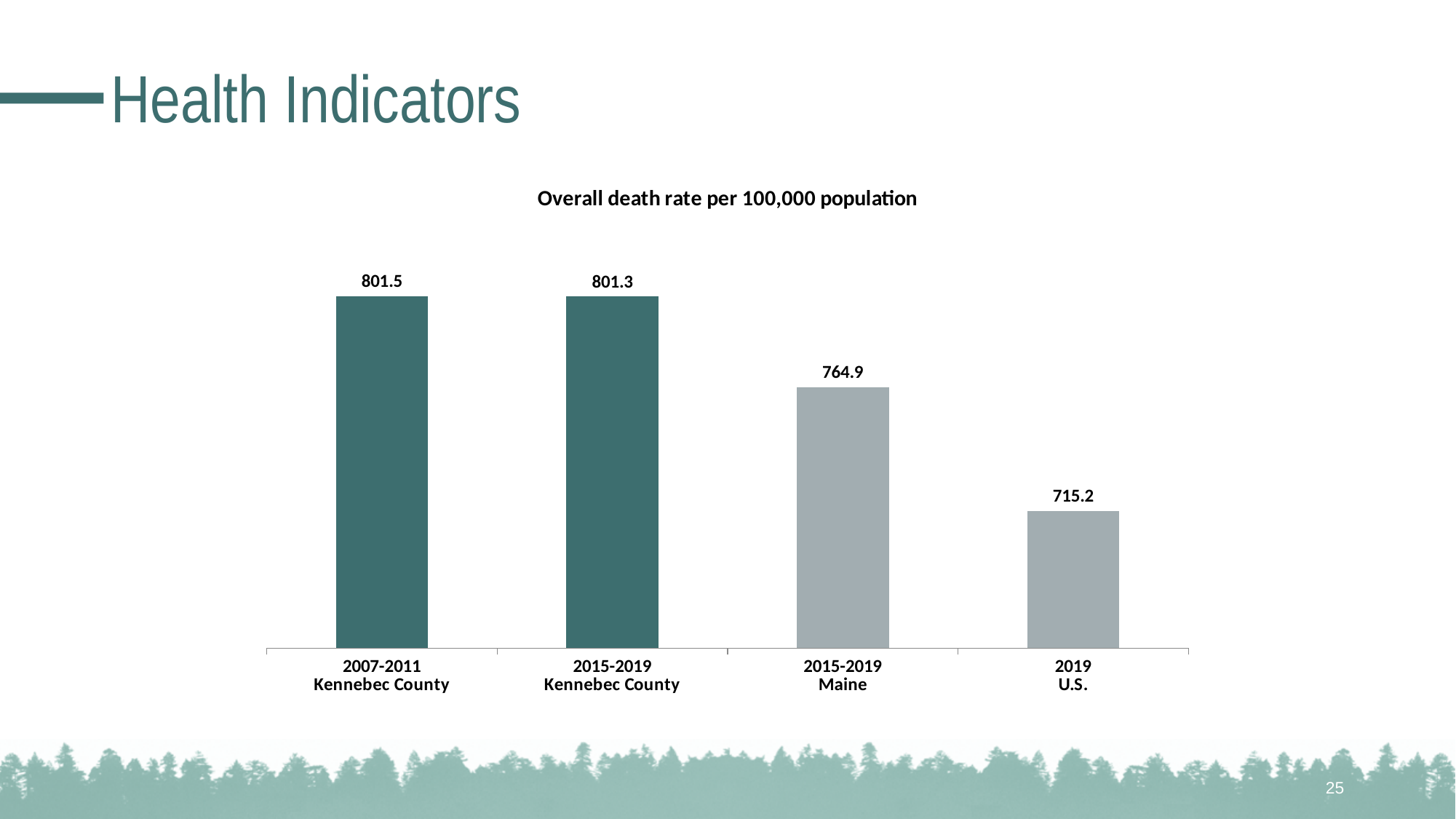
What is the difference between the 2015-2019 Kennebec County death rate and the 2015-2019 Maine death rate? 36.4 How many bars are shown in the chart? 4 What is the overall death rate per 100,000 population for the U.S. in 2019? 715.2 What is the overall death rate per 100,000 population for Kennebec County in 2015-2019? 801.3 What is the difference between the 2015-2019 Maine death rate and the 2019 U.S. death rate? 49.7 What is the overall death rate per 100,000 population for Maine in 2015-2019? 764.9 Which category has the lowest overall death rate per 100,000 population? 2019 U.S. Which category has the highest overall death rate per 100,000 population? 2007-2011 Kennebec County What is the overall death rate per 100,000 population for Kennebec County in 2007-2011? 801.5 Which is larger, the 2015-2019 Maine death rate or the 2019 U.S. death rate? 2015-2019 Maine Do the values rise or fall from left to right across the chart? Fall What kind of chart is shown on the slide? Bar chart